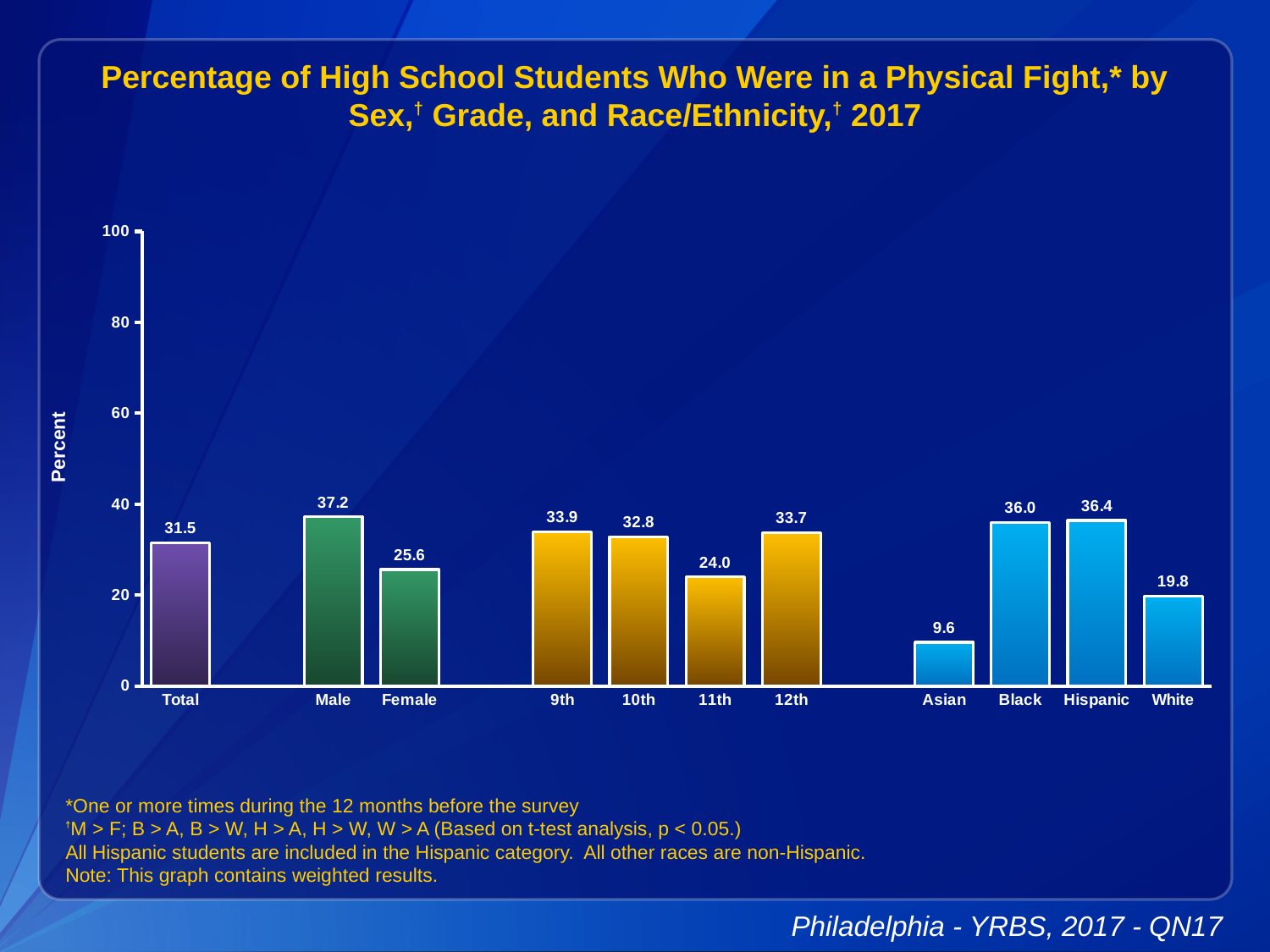
What is the value for Total? 31.5 Which category has the lowest value? Asian Is the value for Hispanic greater or less than 20? greater How many categories are shown on the x axis? 11 What is the value for 11th grade? 24.0 What kind of chart is this? bar chart What is the value for Asian? 9.6 What is the label of the y axis? Percent What is the value for Female? 25.6 What is the difference between the Male and Female values? 11.6 Which category has the highest value? Male Which is larger, the value for Black or the value for White? Black